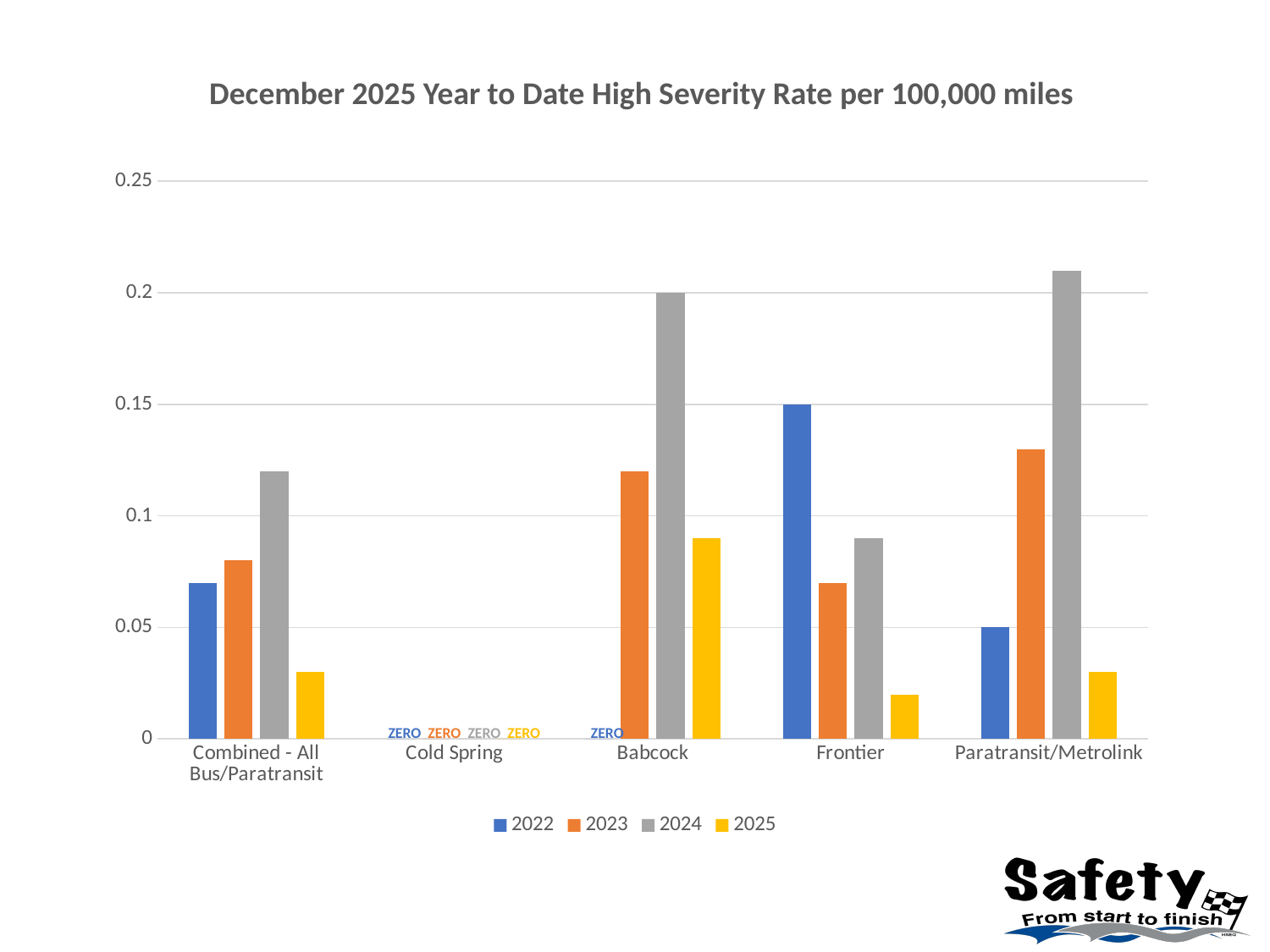
What is the title of the chart? December 2025 Year to Date High Severity Rate per 100,000 miles Is the value for Combined - All Bus/Paratransit in 2024 greater or less than 0.1? greater How many series does the legend list? 4 Which year has the highest value for Frontier? 2022 What value is shown for Cold Spring in 2025? ZERO What is the value for Babcock in 2024? 0.2 Is the value for Frontier in 2025 greater or less than 0.05? less What is the value for Frontier in 2022? 0.15 Which year has the highest value for Babcock? 2024 How many categories are shown along the x axis? 5 What kind of chart is shown on the slide? bar chart What value is shown for Babcock in 2022? ZERO